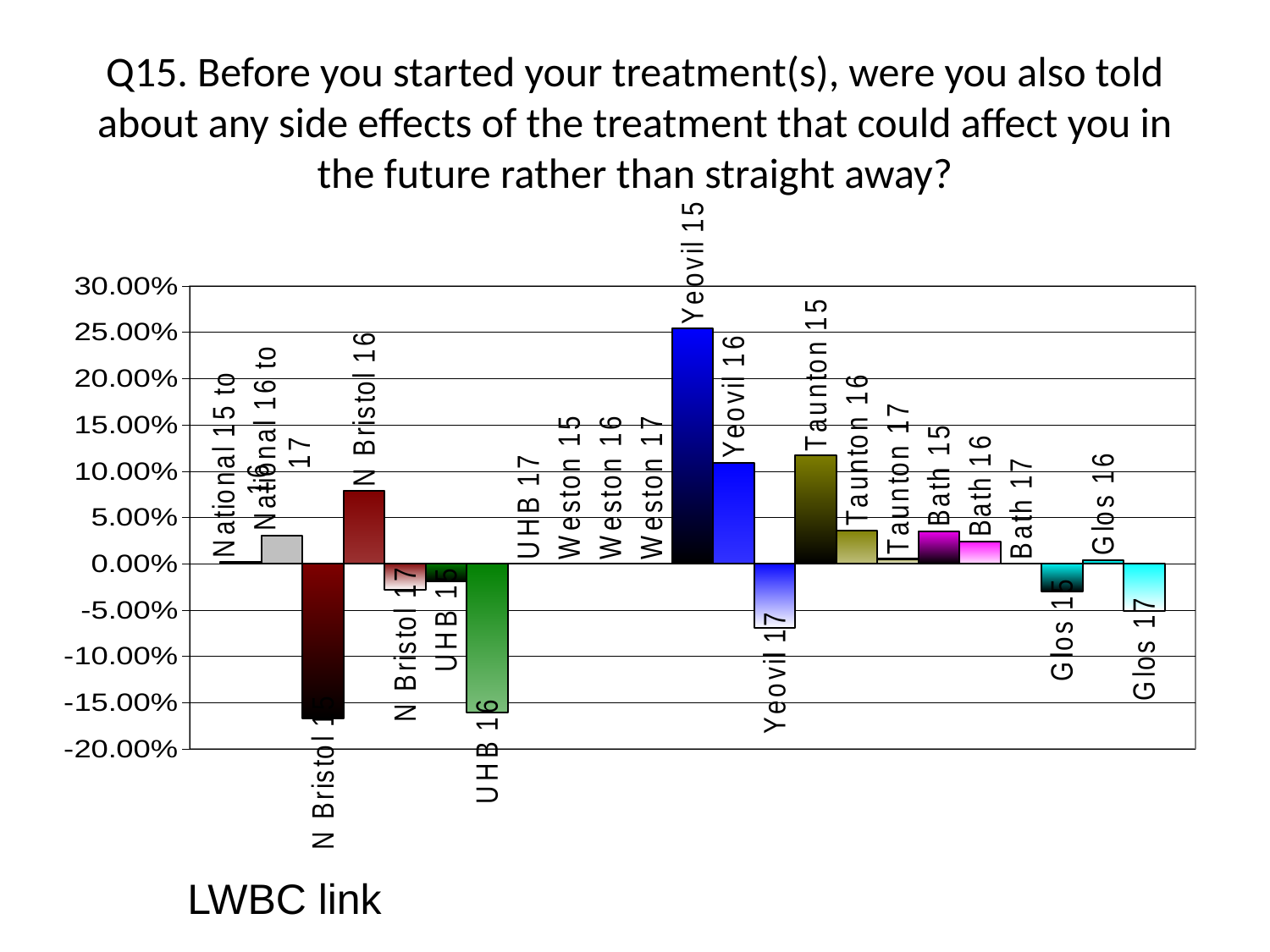
Which is larger, the value for Yeovil 15 or the value for Taunton 15? Yeovil 15 Is the value for N Bristol 16 greater or less than 5.00%? greater Is the value for Yeovil 17 greater or less than -5.00%? less Which category has the highest value? Yeovil 15 Which is larger, the value for Yeovil 16 or the value for N Bristol 16? Yeovil 16 Which is larger, the value for Taunton 15 or the value for Taunton 16? Taunton 15 Is the value for N Bristol 15 greater or less than -15.00%? less What kind of chart is shown on the slide? bar chart How many categories are plotted on the chart? 23